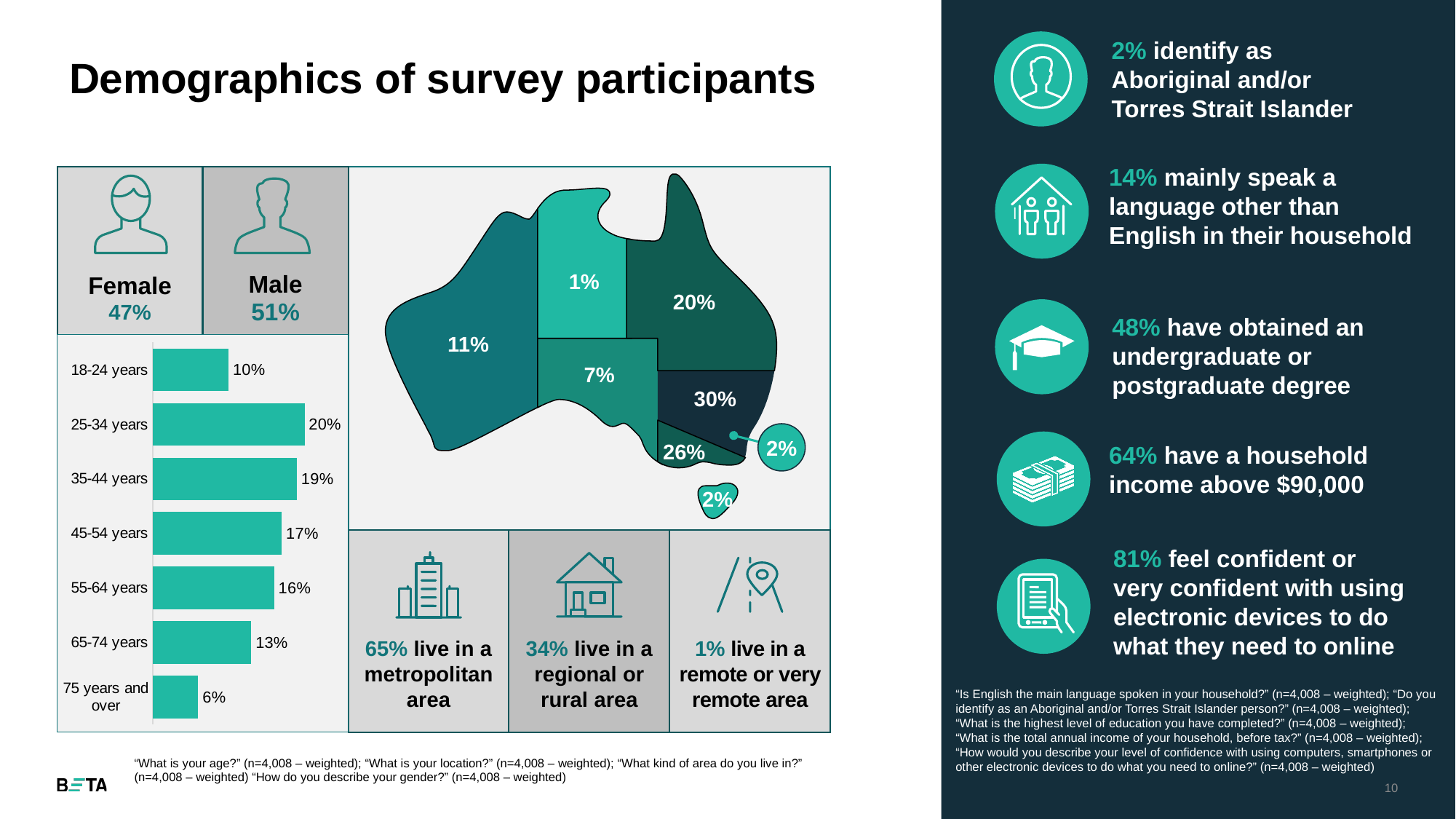
How many age groups are shown in the age bar chart? 7 What colour are the bars in the age bar chart? Teal/green In the age bar chart, do the percentages rise or fall from the 25-34 years group through to the 75 years and over group? Fall In the age bar chart, what percentage of survey participants are 75 years and over? 6% In the age bar chart, what percentage of survey participants are aged 55-64 years? 16% In the age bar chart, which age group has the highest percentage of participants? 25-34 years In the age bar chart, which group has a larger share of participants: 45-54 years or 65-74 years? 45-54 years In the age bar chart, which age group has the lowest percentage of participants? 75 years and over In the age bar chart, what percentage of survey participants are aged 18-24 years? 10% What type of chart is used to show the age distribution of survey participants? Bar chart In the age bar chart, what is the difference in percentage points between the 25-34 years group and the 65-74 years group? 7 In the age bar chart, what is the combined percentage of participants aged 18-24 years and 25-34 years? 30%